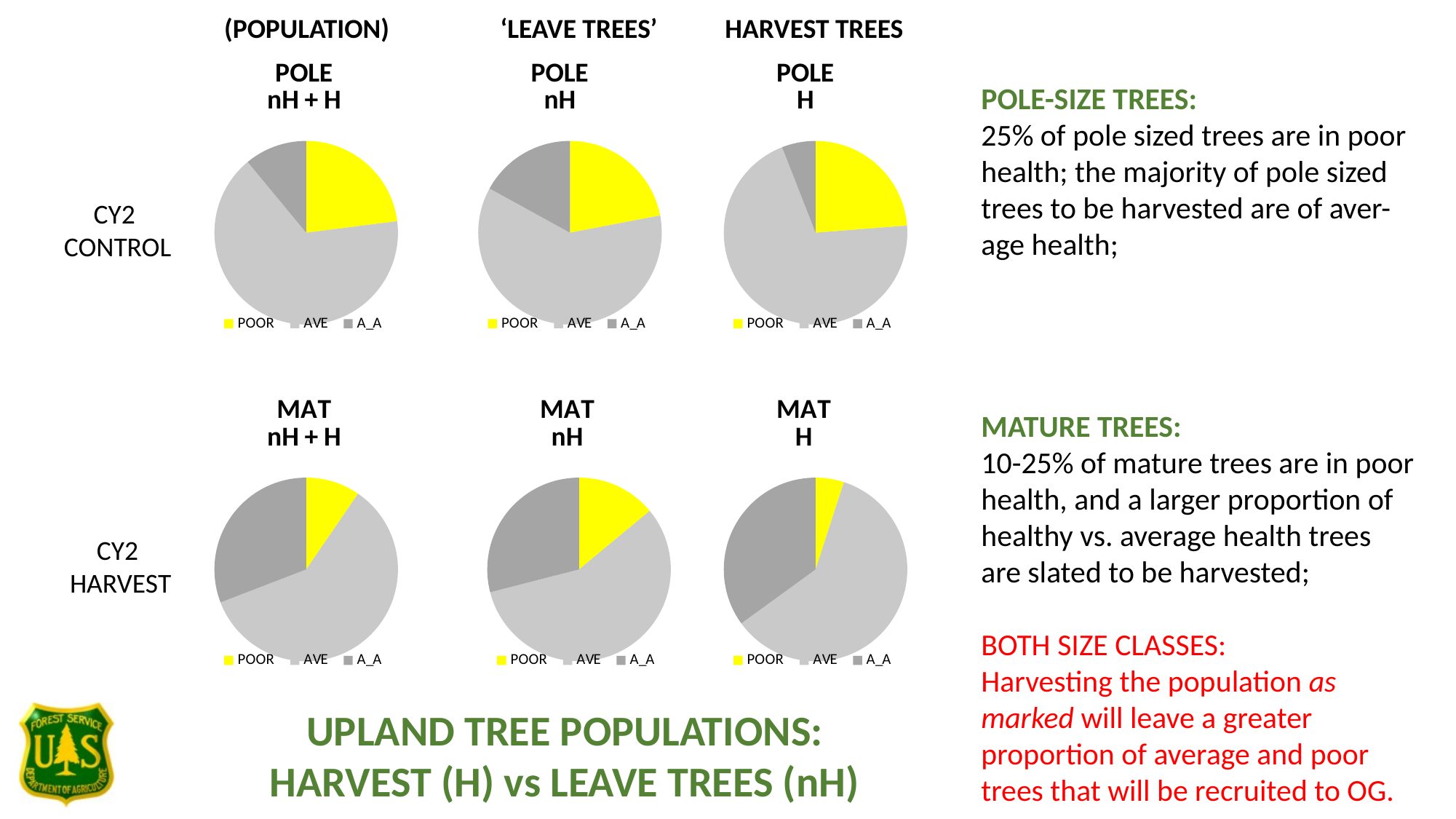
In the 'MAT H' chart, which slice is larger, A_A or POOR? A_A In the 'MAT H' chart, which category has the smallest slice? POOR In the 'POLE H' chart, which slice is larger, POOR or A_A? POOR What are the legend entries of the 'MAT nH' chart? POOR, AVE, A_A How many pie charts are shown on the slide? 6 In the 'POLE H' chart, which category has the largest slice? AVE In the 'POLE nH + H' chart, which category has the smallest slice? A_A In the 'MAT nH + H' chart, which category has the largest slice? AVE What colour represents the POOR category in the pie charts? yellow What kind of chart is the 'POLE nH + H' chart? pie chart How many categories does the legend of the 'MAT H' chart list? 3 In the 'POLE H' chart, which category has the smallest slice? A_A